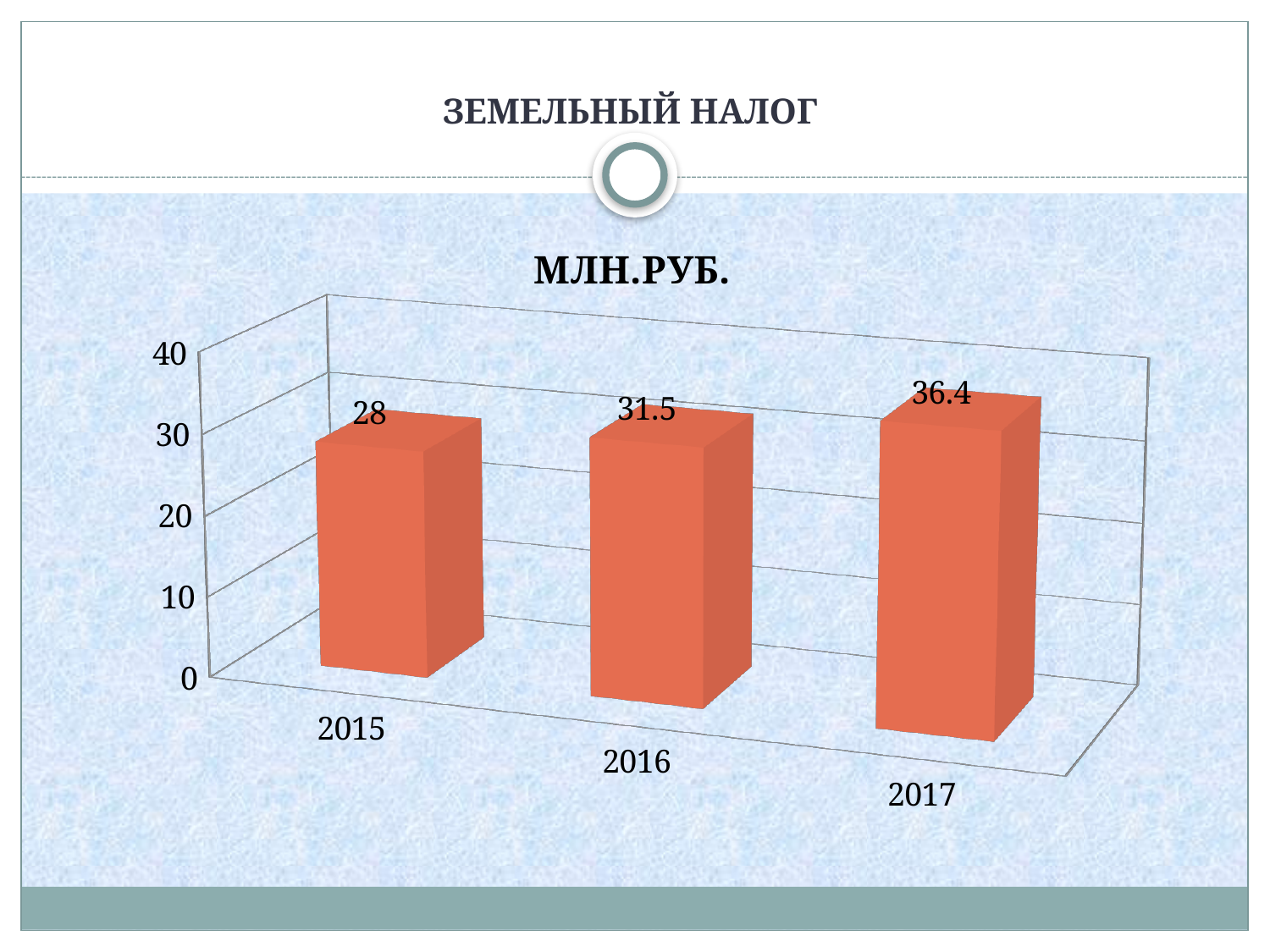
What is the difference between the values for 2016 and 2015? 3.5 Which year has the highest value? 2017 What is the value for 2015? 28 What kind of chart is shown on the slide? bar chart What is the difference between the values for 2017 and 2015? 8.4 Which is larger, the value for 2016 or the value for 2017? 2017 What is the value for 2016? 31.5 How many years are shown on the chart? 3 What is the value for 2017? 36.4 Is the value for 2015 greater or less than 30? less Do the values rise or fall from 2015 to 2017? rise Which year has the lowest value? 2015